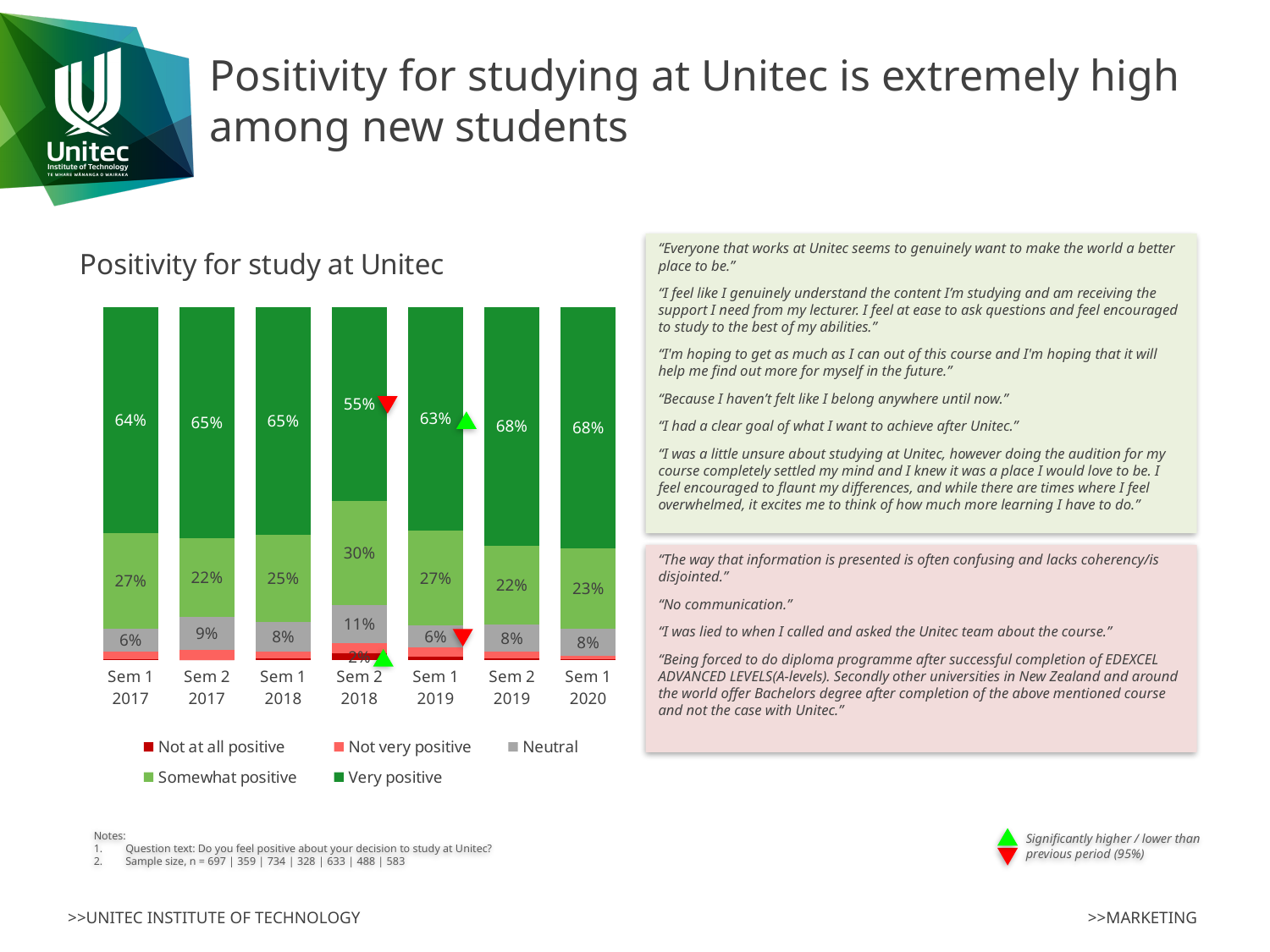
What is the Very positive value for Sem 1 2020? 68% What kind of chart is shown? Stacked bar chart How many semesters are shown on the x axis? 7 Which is larger, the Somewhat positive value for Sem 1 2018 or for Sem 2 2019? Sem 1 2018 Which semester has the lowest Very positive value? Sem 2 2018 What is the Somewhat positive value for Sem 2 2018? 30% What is the title of the chart? Positivity for study at Unitec Does the Very positive value rise or fall from Sem 2 2018 to Sem 2 2019? Rise What is the difference between the Very positive values for Sem 1 2019 and Sem 2 2018? 8 percentage points Which semester has the highest Neutral value? Sem 2 2018 How many series does the legend list? 5 What is the Neutral value for Sem 2 2017? 9%